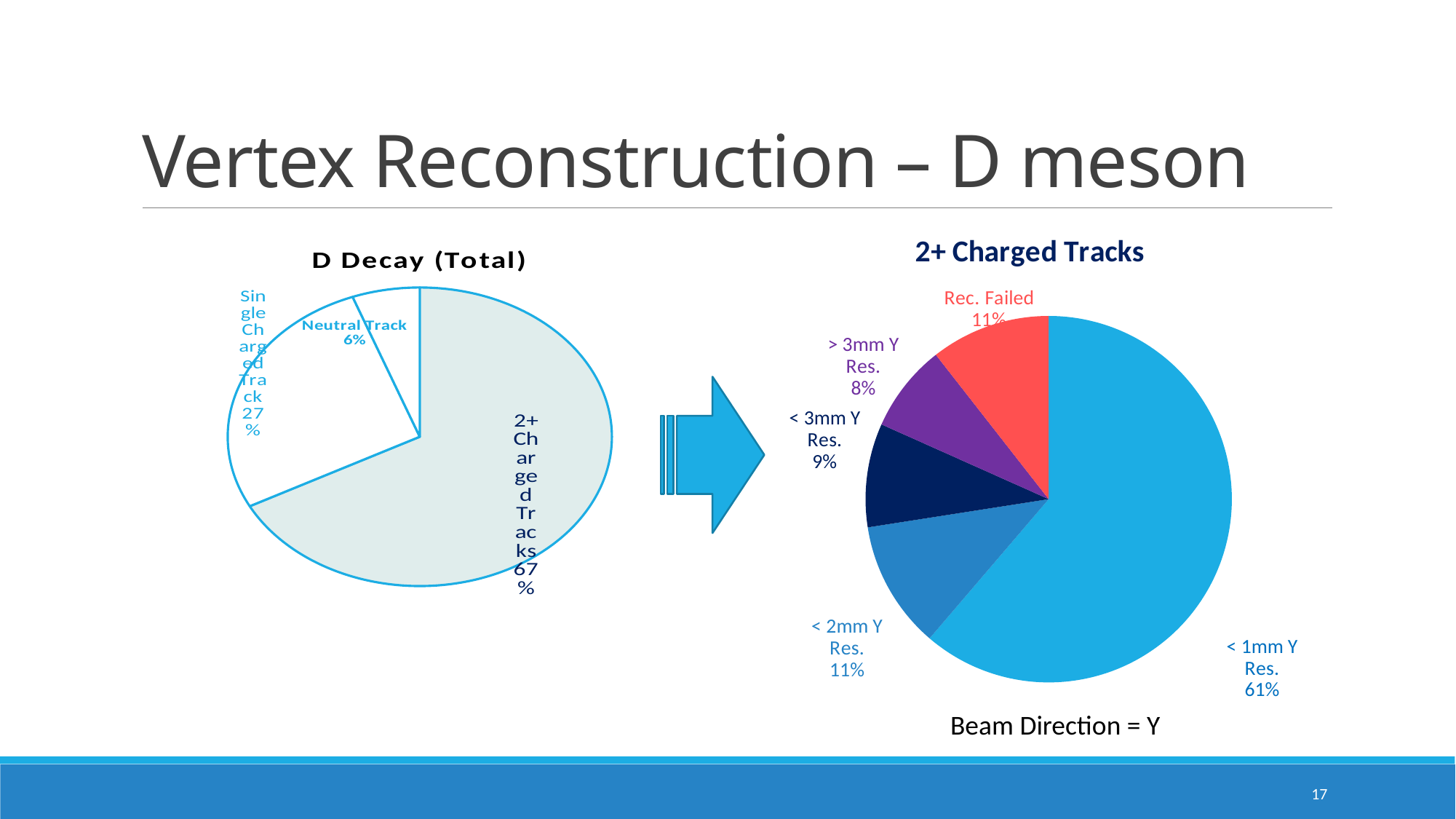
In the 'D Decay (Total)' chart, what share of the pie is 2+ Charged Tracks? 67% In the '2+ Charged Tracks' chart, which category has the smallest slice? > 3mm Y Res. In the 'D Decay (Total)' chart, which category has the smallest slice? Neutral Track What type of chart is the '2+ Charged Tracks' chart? Pie chart In the 'D Decay (Total)' chart, how many slices does the pie have? 3 In the '2+ Charged Tracks' chart, which category has the largest slice? < 1mm Y Res. In the '2+ Charged Tracks' chart, what percentage is shown for Rec. Failed? 11% In the 'D Decay (Total)' chart, what percentage is shown for Single Charged Track? 27% In the 'D Decay (Total)' chart, what percentage is shown for Neutral Track? 6% In the '2+ Charged Tracks' chart, how many slices does the pie have? 5 In the '2+ Charged Tracks' chart, what percentage is shown for < 1mm Y Res.? 61% In the '2+ Charged Tracks' chart, what is the difference in percentage points between < 1mm Y Res. and < 2mm Y Res.? 50